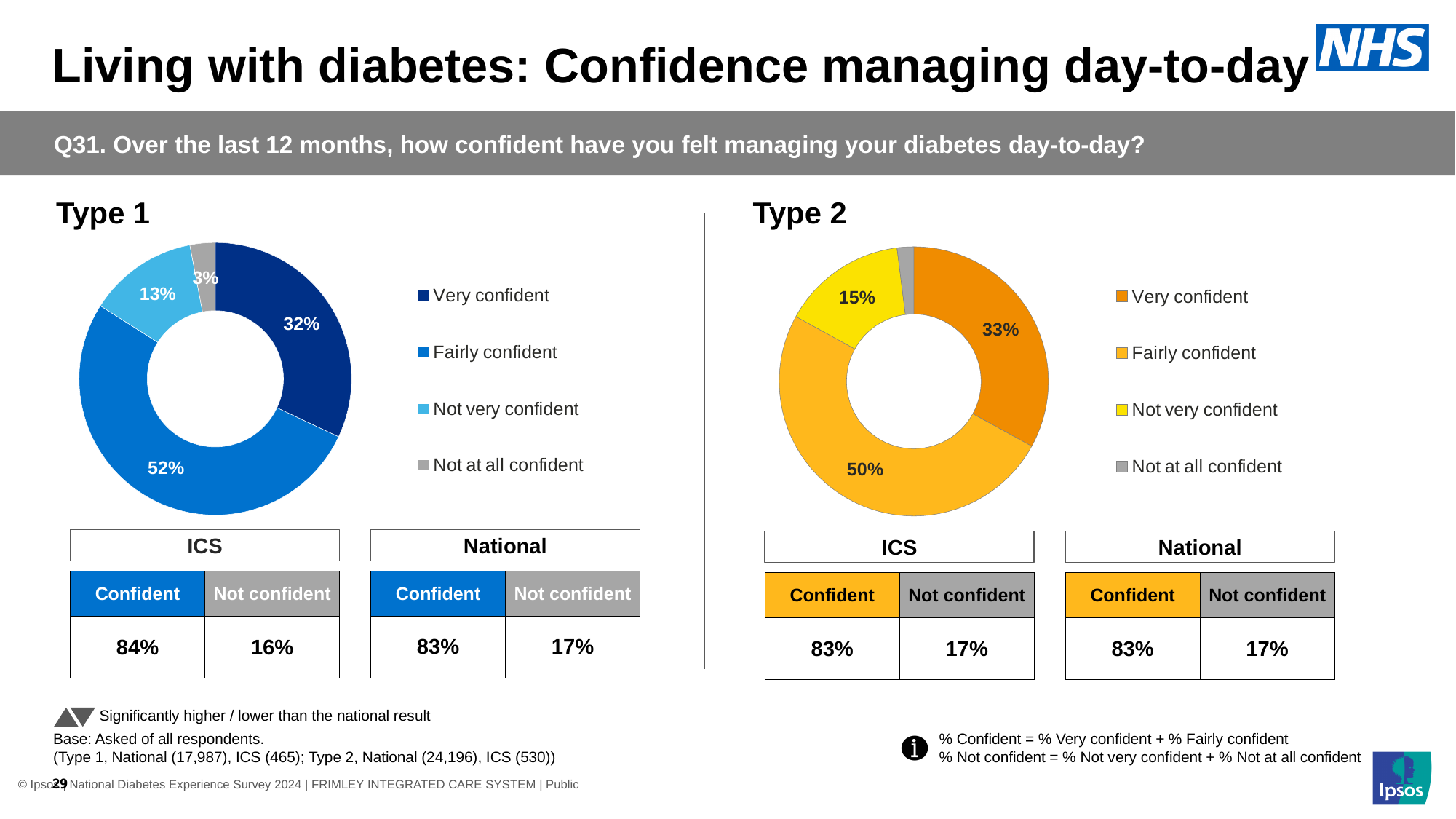
In the Type 1 chart, what percentage of respondents were Fairly confident? 52% What kind of chart is used for Type 1? Donut (pie) chart In the Type 1 chart, which category has the largest share? Fairly confident In the Type 1 chart, what colour represents Very confident? Dark blue How many categories does the legend of the Type 2 chart list? 4 In the Type 1 chart, which category has the smallest share? Not at all confident In the Type 1 chart, what is the difference between the Fairly confident and Very confident shares? 20 percentage points In the Type 2 chart, what percentage of respondents were Not very confident? 15% In the Type 2 chart, which category has the largest share? Fairly confident In the Type 1 chart, what percentage of respondents were Not very confident? 13% In the Type 2 chart, what percentage of respondents were Very confident? 33% In the Type 2 chart, which is larger: the Very confident share or the Not very confident share? Very confident